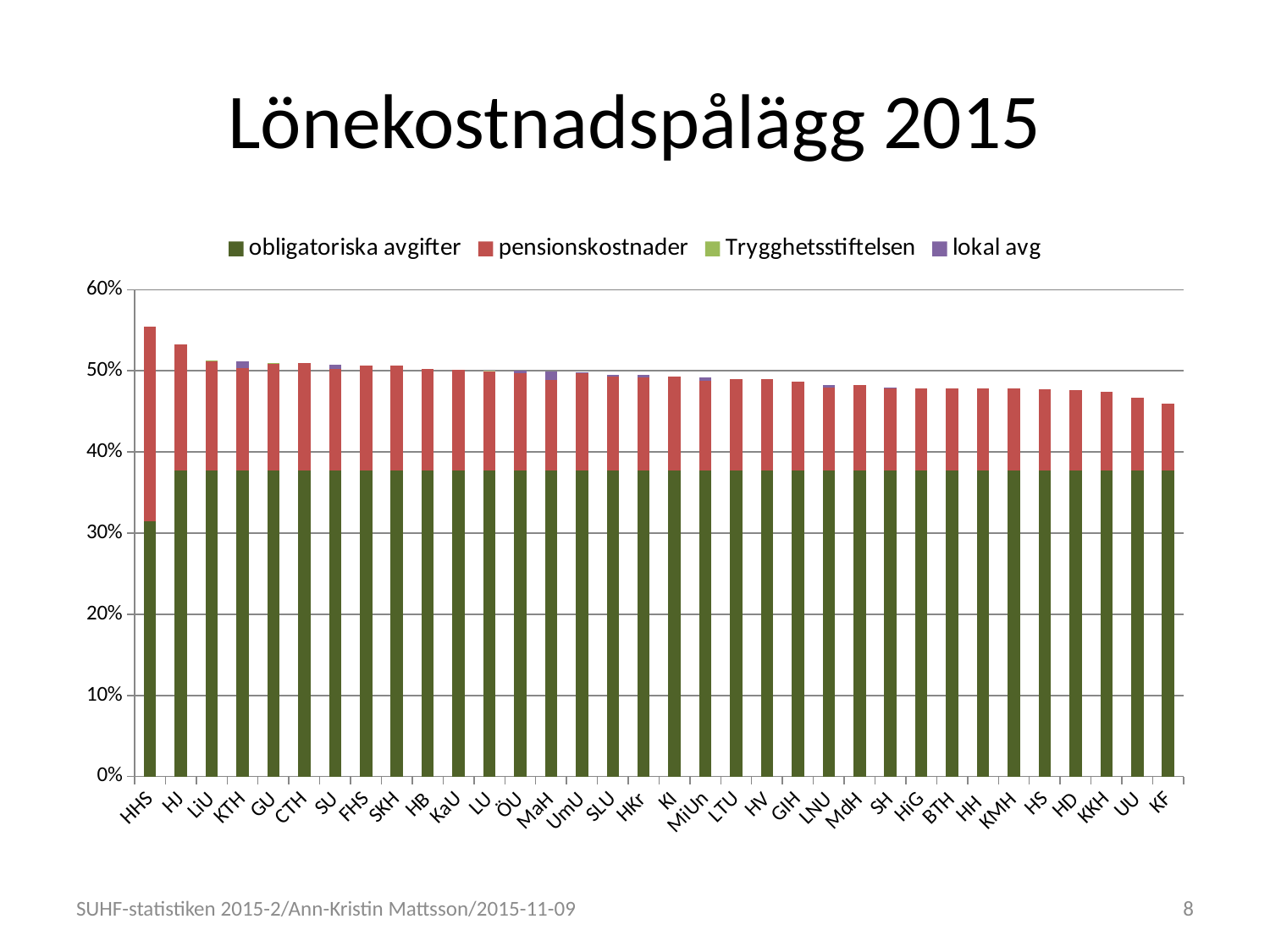
Which series is shown in green at the bottom of each stacked bar? obligatoriska avgifter Is the total value for HHS greater or less than 50%? greater How many series does the legend list? 4 Which has the larger obligatoriska avgifter value, HHS or HJ? HJ How many categories are shown along the x axis? 34 Is the obligatoriska avgifter value for HJ greater or less than 40%? less Do the total bar heights rise or fall from left to right along the x axis? fall Is the total value for KF greater or less than 50%? less What is the title of the chart? Lönekostnadspålägg 2015 Which category has the lowest total bar? KF Which category has the highest total bar? HHS What kind of chart is shown on the slide? bar chart